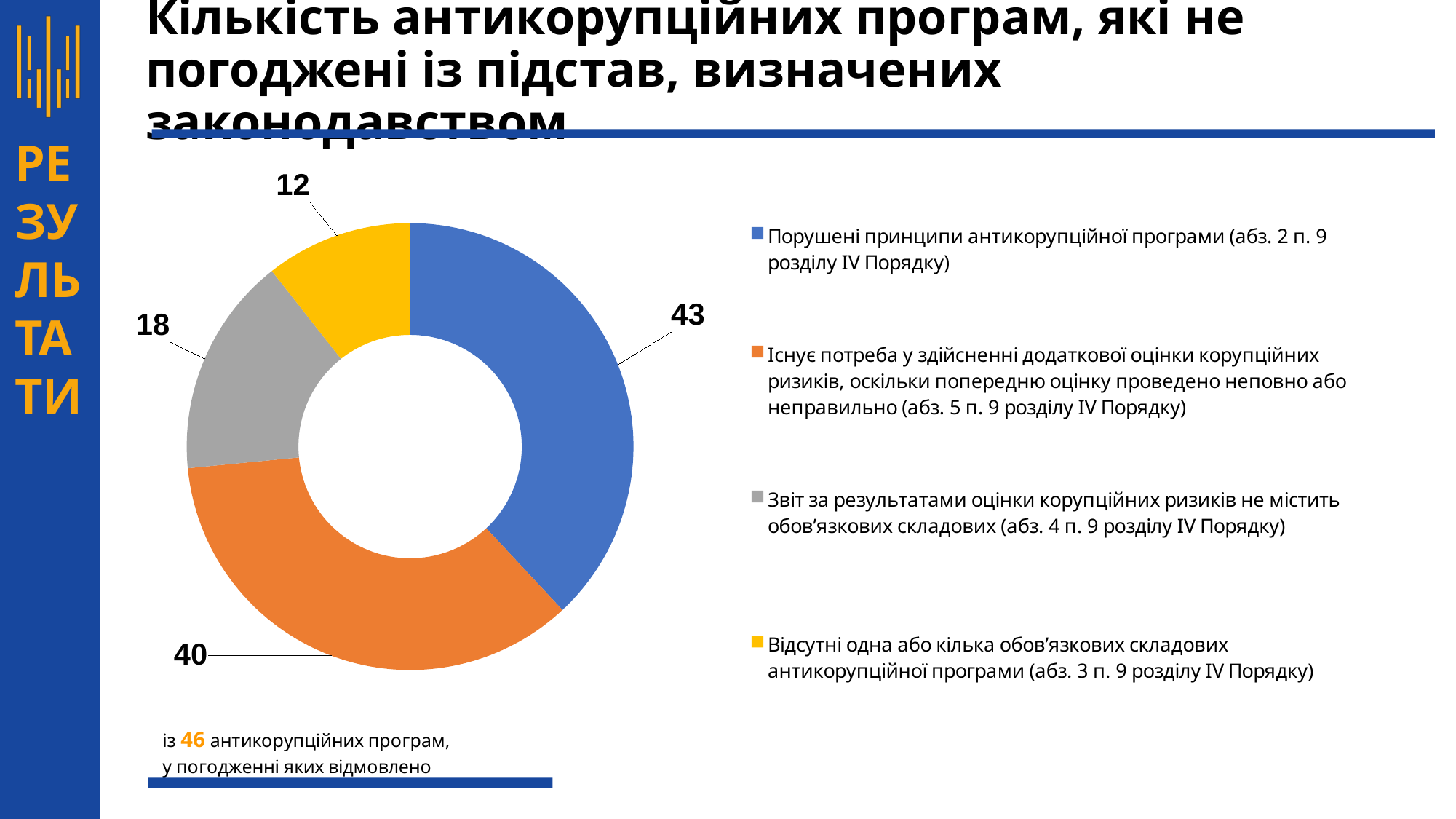
What is the difference between the largest slice (43) and the smallest slice (12)? 31 Which category has the lowest value in the chart? Відсутні одна або кілька обов’язкових складових антикорупційної програми (абз. 3 п. 9 розділу IV Порядку) How many slices does the chart have? 4 How many entries does the legend list? 4 What type of chart is shown on the slide? Doughnut (pie) chart Which category has the highest value in the chart? Порушені принципи антикорупційної програми (абз. 2 п. 9 розділу IV Порядку) What is the value for the slice 'Відсутні одна або кілька обов’язкових складових антикорупційної програми (абз. 3 п. 9 розділу IV Порядку)'? 12 What is the value for the slice 'Порушені принципи антикорупційної програми (абз. 2 п. 9 розділу IV Порядку)'? 43 Which is larger: the slice for 'Звіт за результатами оцінки корупційних ризиків не містить обов’язкових складових' or the slice for 'Відсутні одна або кілька обов’язкових складових антикорупційної програми'? Звіт за результатами оцінки корупційних ризиків не містить обов’язкових складових What is the value for the slice 'Звіт за результатами оцінки корупційних ризиків не містить обов’язкових складових (абз. 4 п. 9 розділу IV Порядку)'? 18 What is the value for the slice 'Існує потреба у здійсненні додаткової оцінки корупційних ризиків, оскільки попередню оцінку проведено неповно або неправильно (абз. 5 п. 9 розділу IV Порядку)'? 40 What colour is the slice with the value 40? Orange